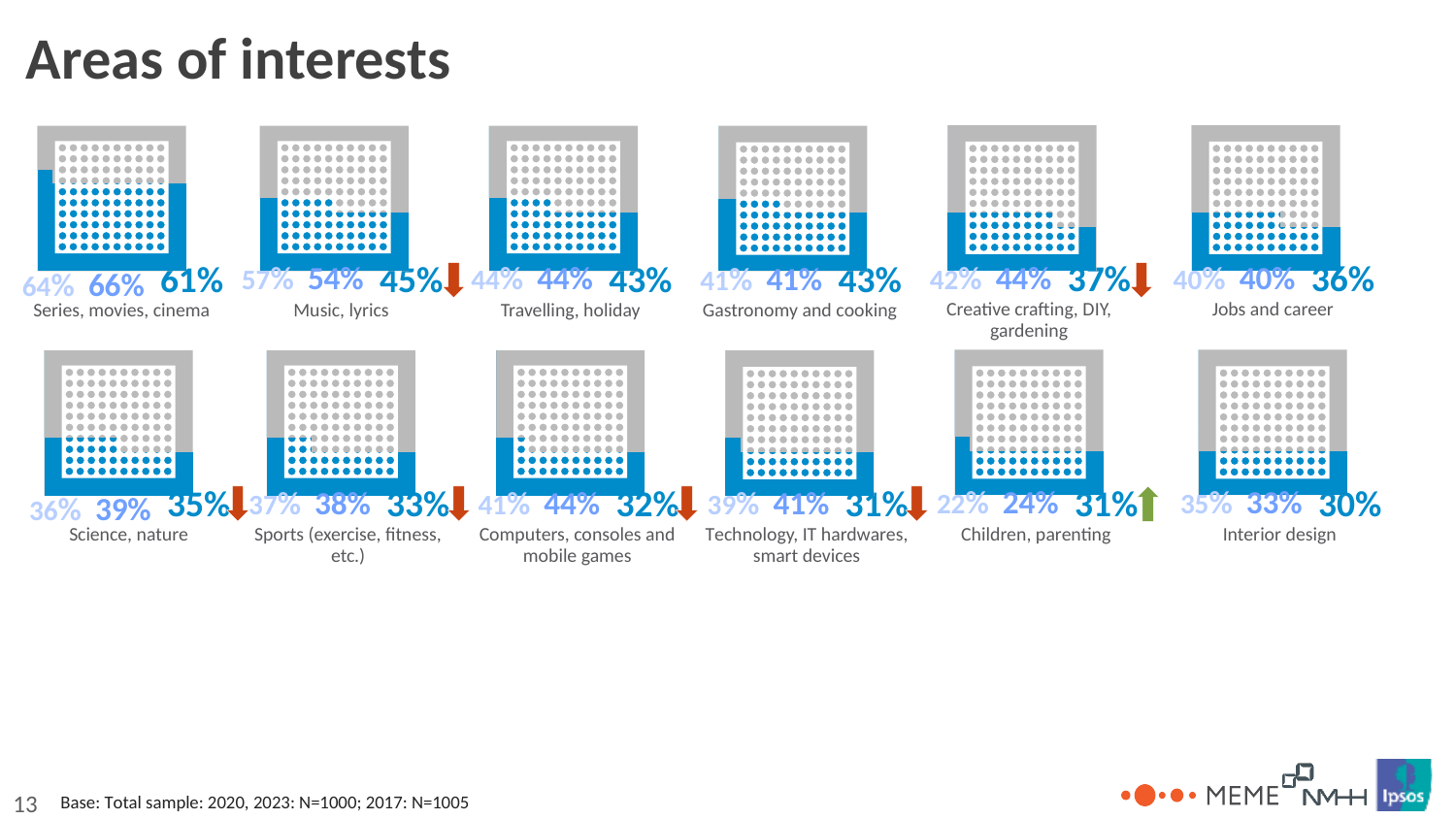
Which has the larger rightmost (bold) value: Gastronomy and cooking or Jobs and career? Gastronomy and cooking What is the rightmost (bold) value shown for Series, movies, cinema? 61% What is the middle value shown for Computers, consoles and mobile games? 44% Which area of interest has the highest rightmost (bold) value? Series, movies, cinema What is the first (leftmost) value shown for Music, lyrics? 57% Do the three values for Children, parenting rise or fall from left to right? Rise What is the rightmost (bold) value shown for Children, parenting? 31% Which area of interest is marked with a green upward arrow? Children, parenting What kind of chart is used to show each area of interest? Pictograph (waffle/dot grid chart) Which area of interest has the lowest rightmost (bold) value? Interior design How many areas of interest are shown on the slide? 12 What is the difference between the first and the rightmost (bold) value for Music, lyrics? 12 percentage points